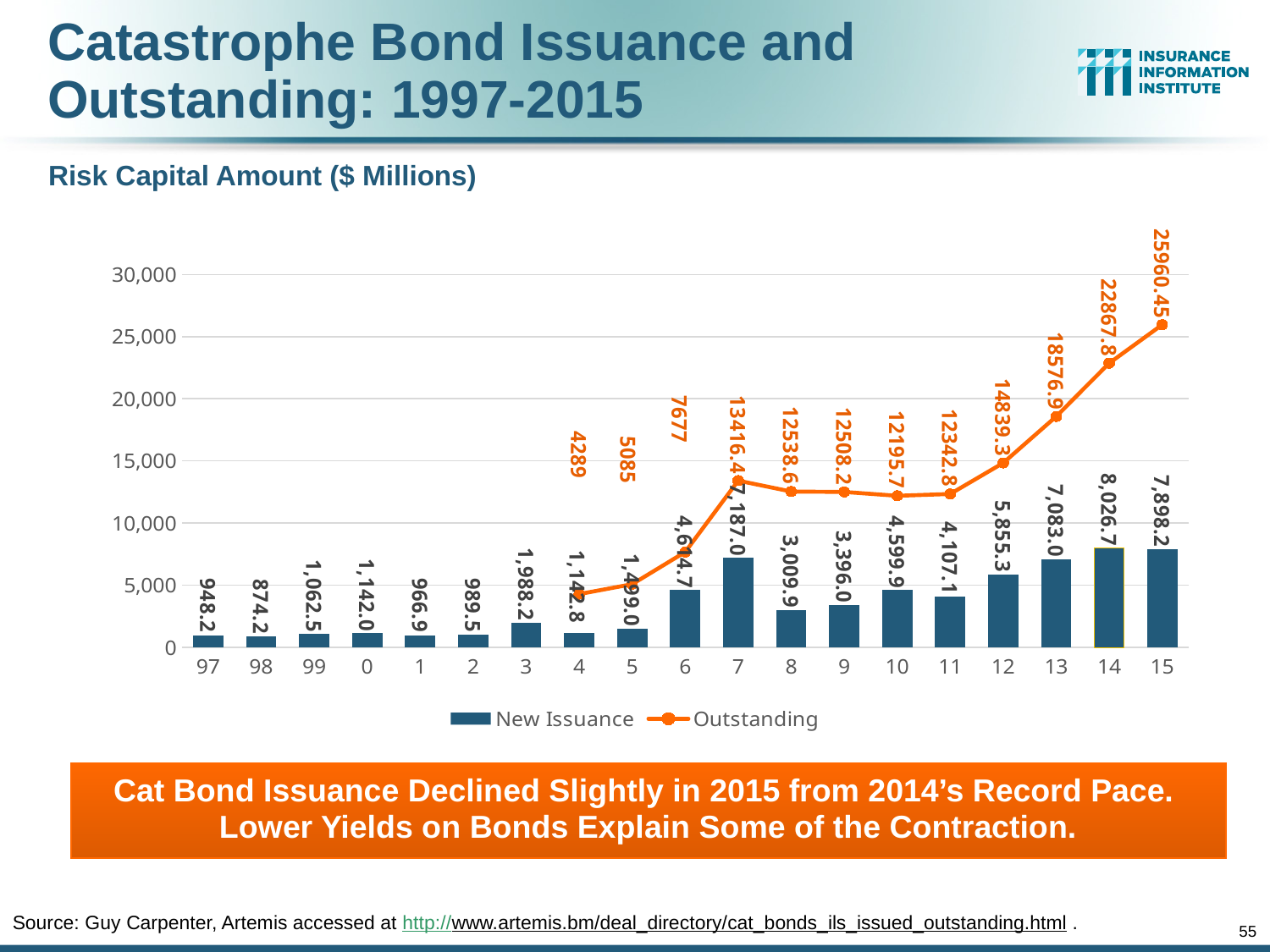
What is the difference between the New Issuance values for 2014 (label 14) and 2015 (label 15)? 128.5 What is the Outstanding value for 2015 (label 15)? 25960.45 Which year has the lowest New Issuance value? 98 What is the New Issuance value for 2014 (label 14)? 8,026.7 How many series does the legend list? 2 Which year has the highest New Issuance value? 14 How many years are shown on the x axis? 19 Does the Outstanding line rise or fall from 2012 (label 12) to 2015 (label 15)? rise Which is larger, the New Issuance value for 2006 (label 6) or for 2008 (label 8)? 2006 (label 6) What unit is stated for the risk capital amounts in the chart? $ Millions What is the New Issuance value for 1997 (label 97)? 948.2 What is the Outstanding value for 2007 (label 7)? 13416.4